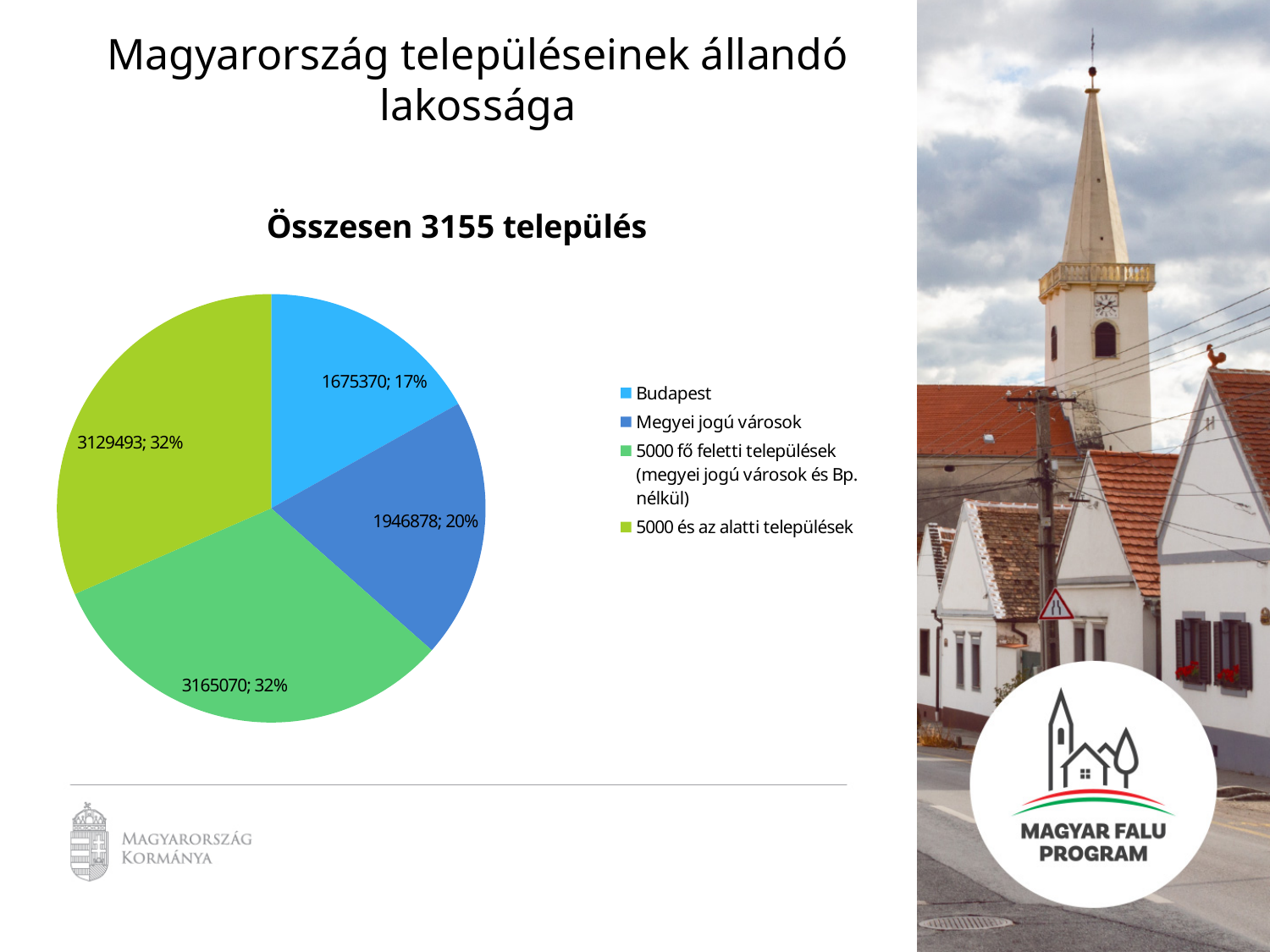
What is the title of the chart? Összesen 3155 település What is the difference between the values for Megyei jogú városok and Budapest? 271508 What is the value shown for Budapest on the pie chart? 1675370 What percentage share does the Budapest slice show? 17% Which is larger, the value for Budapest or the value for Megyei jogú városok? Megyei jogú városok What percentage share does the Megyei jogú városok slice show? 20% Which category has the largest value on the pie chart? 5000 fő feletti települések (megyei jogú városok és Bp. nélkül) How many slices does the pie chart have? 4 What colour is the slice for 5000 és az alatti települések? Yellow-green Which category has the smallest value on the pie chart? Budapest What kind of chart is shown on the slide? Pie chart What is the value shown for 5000 fő feletti települések (megyei jogú városok és Bp. nélkül)? 3165070